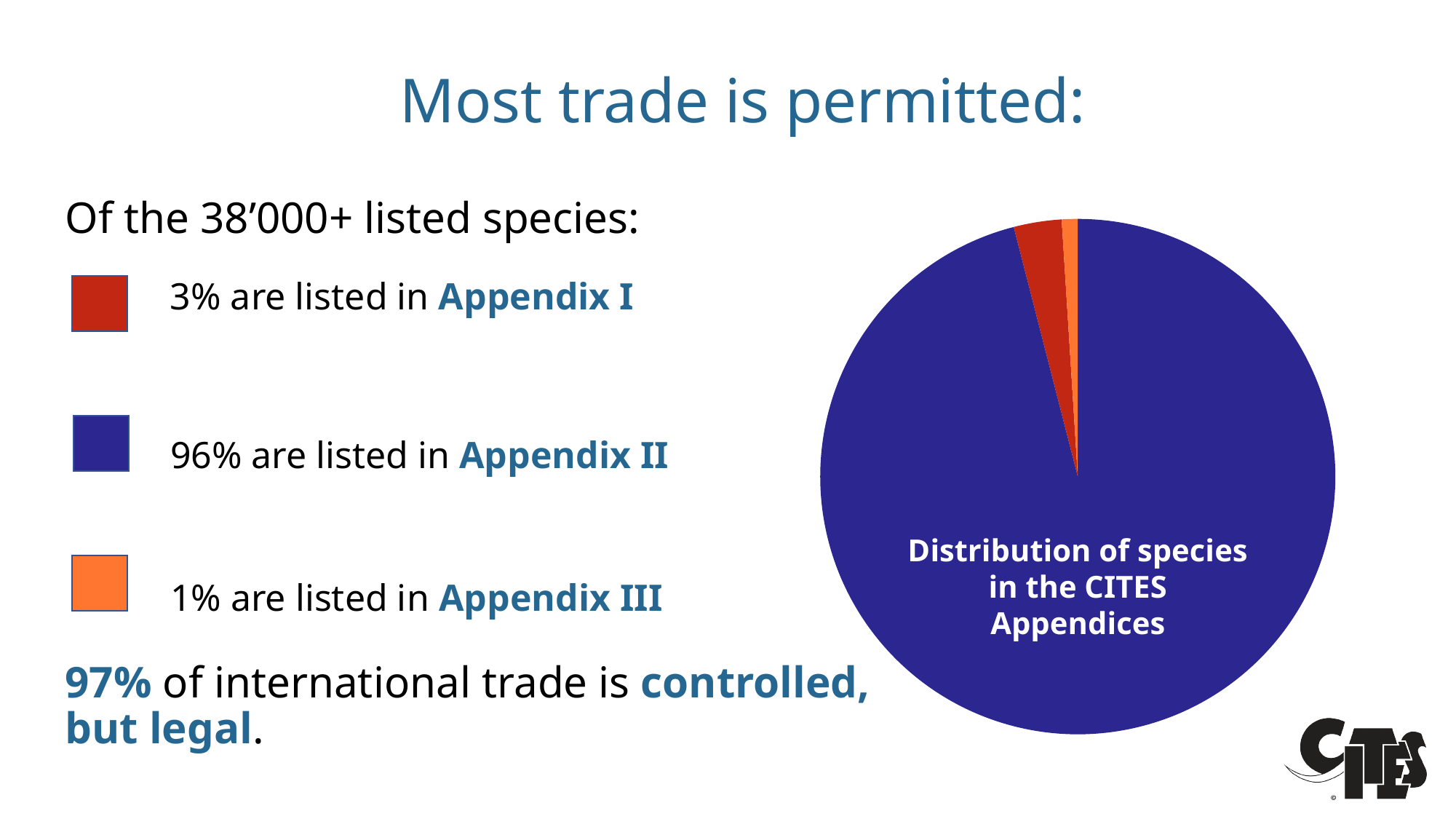
What share of listed species is in Appendix III according to the pie chart? 1% What is the title printed on the pie chart? Distribution of species in the CITES Appendices What colour is the slice for Appendix III in the pie chart? orange How many slices does the pie chart have? 3 What is the difference between the share for Appendix II and the share for Appendix I? 93% Which is larger, the share for Appendix I or the share for Appendix III? Appendix I What share of listed species is in Appendix II according to the pie chart? 96% What share of listed species is in Appendix I according to the pie chart? 3% What is the difference between the share for Appendix I and the share for Appendix III? 2% Which Appendix has the smallest slice of the pie chart? Appendix III What kind of chart is shown on the slide? pie chart Which Appendix has the largest slice of the pie chart? Appendix II